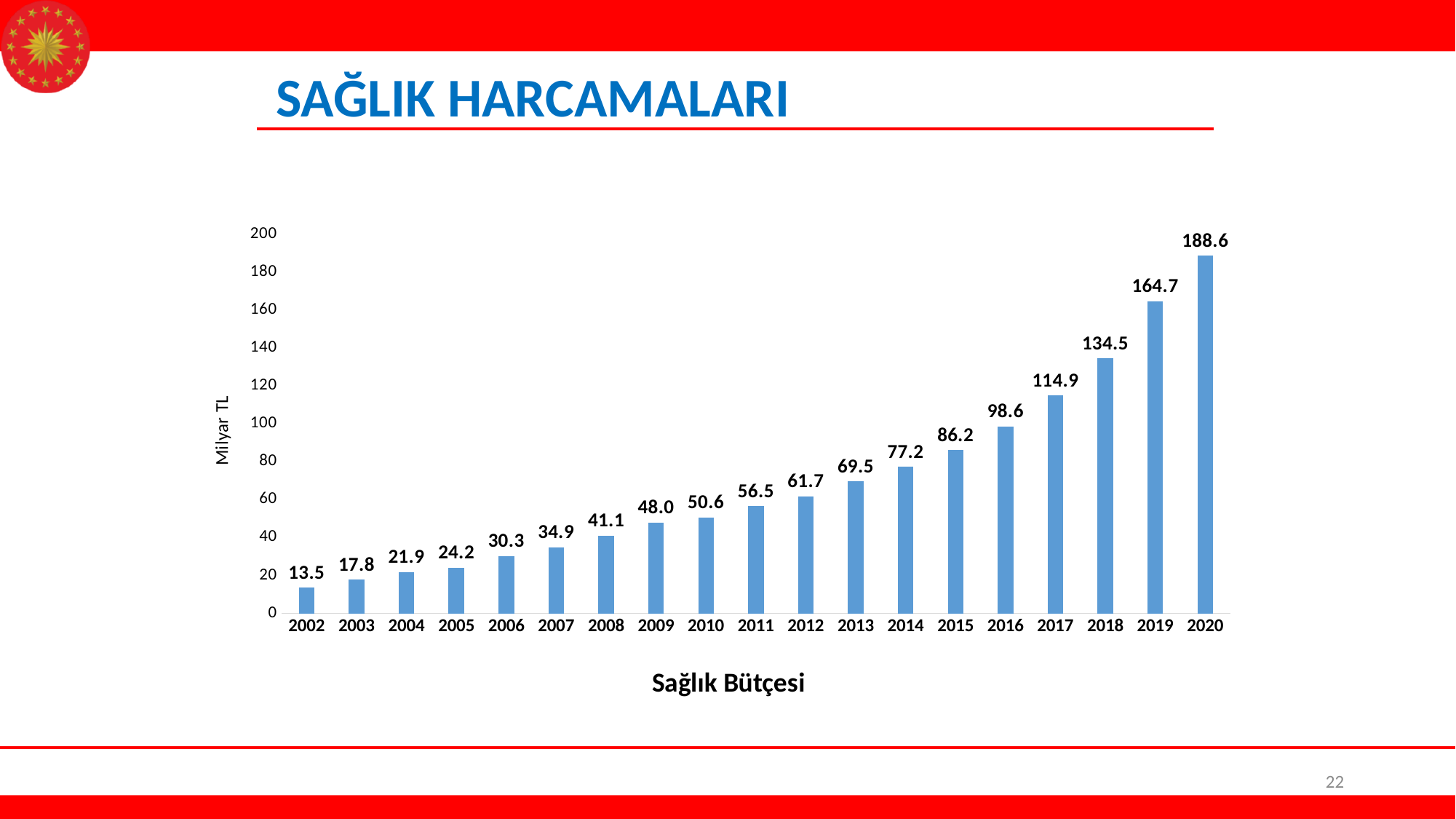
What is the difference between the values for 2012 and 2011? 5.2 Is the value for 2018 greater or less than 120? greater What is the value for 2002? 13.5 Which year has the lowest value? 2002 How many years are shown on the x axis? 19 Do the values rise or fall from 2002 to 2020? rise What kind of chart is shown on the slide? bar chart Which is larger, the value for 2015 or the value for 2014? 2015 What is the value for 2010? 50.6 Which year has the highest value? 2020 What is the difference between the values for 2020 and 2019? 23.9 What is the value for 2017? 114.9